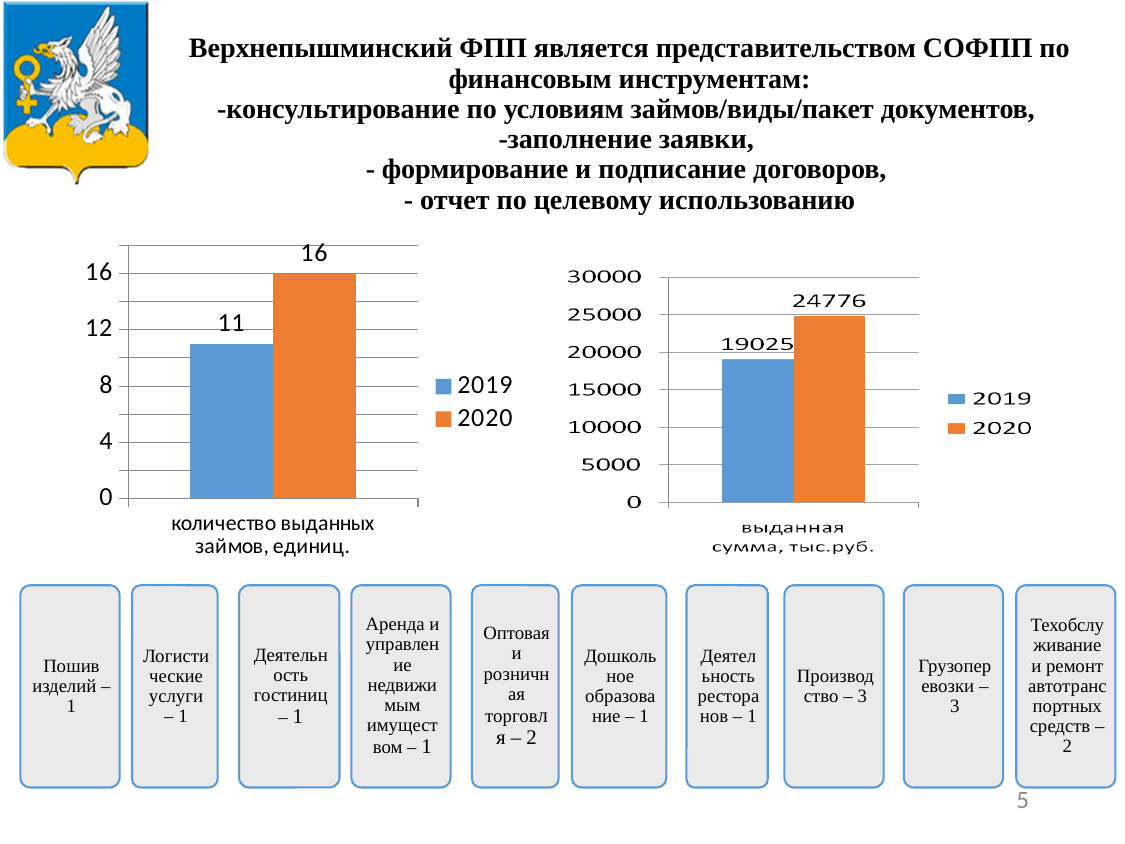
In the right chart (выданная сумма, тыс.руб.), which colour represents 2020? orange In the right chart (выданная сумма, тыс.руб.), what is the difference between the 2020 and 2019 values? 5751 In the left chart (количество выданных займов, единиц.), which year has the higher value? 2020 In the right chart (выданная сумма, тыс.руб.), what is the value for 2020? 24776 In the left chart (количество выданных займов, единиц.), what is the value for 2019? 11 How many series does the legend of the left chart (количество выданных займов, единиц.) list? 2 In the right chart (выданная сумма, тыс.руб.), is the value for 2019 greater or less than 20000? less In the left chart (количество выданных займов, единиц.), what is the value for 2020? 16 In the right chart (выданная сумма, тыс.руб.), what is the value for 2019? 19025 In the right chart (выданная сумма, тыс.руб.), which year has the lower value? 2019 In the left chart (количество выданных займов, единиц.), what is the difference between the 2020 and 2019 values? 5 What kind of chart is the right chart (выданная сумма, тыс.руб.)? bar chart